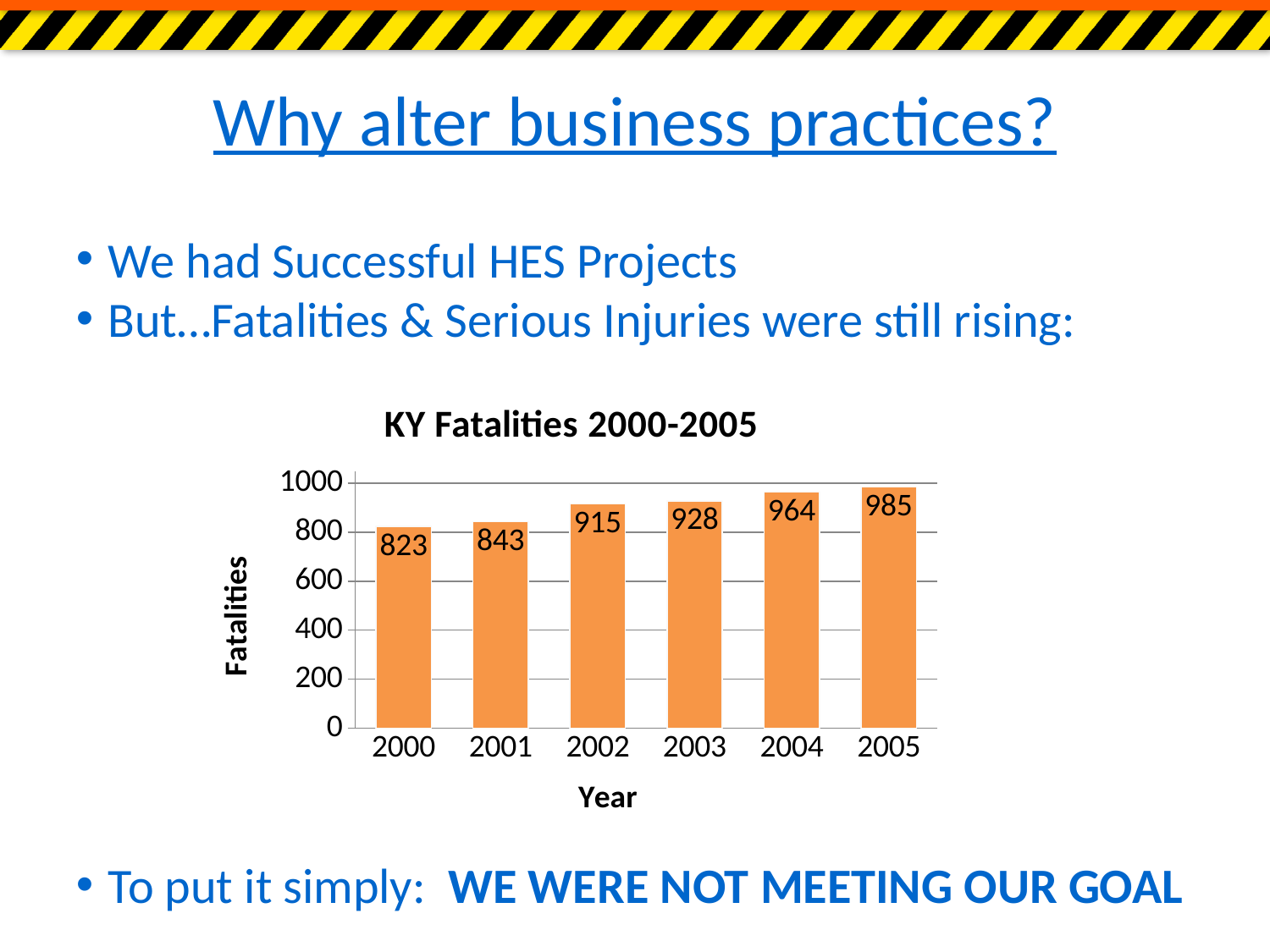
Which year has the highest number of fatalities in the chart? 2005 What kind of chart is shown on the slide? bar chart Do the fatalities rise or fall from 2000 to 2005? rise What is the value for 2003 in the KY Fatalities 2000-2005 chart? 928 What is the value for 2000 in the KY Fatalities 2000-2005 chart? 823 Is the value for 2001 greater or less than 800? greater Which year has the lowest number of fatalities in the chart? 2000 What is the difference between the fatalities in 2005 and 2000? 162 What is the difference between the fatalities in 2002 and 2001? 72 Which year has more fatalities, 2002 or 2004? 2004 How many years are shown on the x axis of the chart? 6 What is the value for 2005 in the KY Fatalities 2000-2005 chart? 985